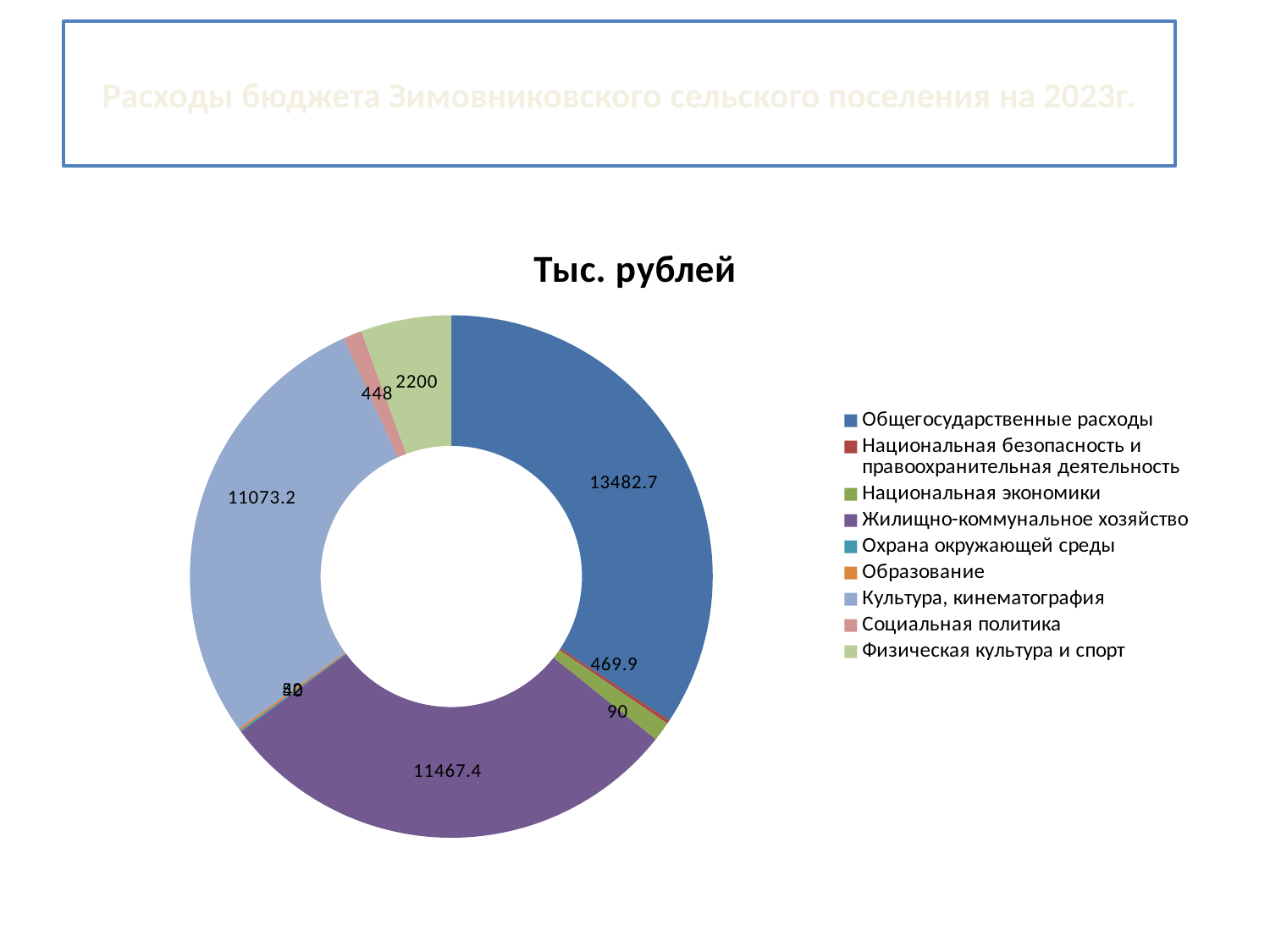
What is the difference between Физическая культура и спорт and Социальная политика? 1752 Which category has the largest value? Общегосударственные расходы Which is larger: Физическая культура и спорт or Социальная политика? Физическая культура и спорт What is the value for Социальная политика? 448 How many categories does the chart legend list? 9 What is the title of the chart? Тыс. рублей What is the value for Общегосударственные расходы? 13482.7 What is the value for Физическая культура и спорт? 2200 What is the value for Жилищно-коммунальное хозяйство? 11467.4 What is the value for Культура, кинематография? 11073.2 What is the difference between Общегосударственные расходы and Жилищно-коммунальное хозяйство? 2015.3 What kind of chart is shown on the slide? Doughnut (pie) chart